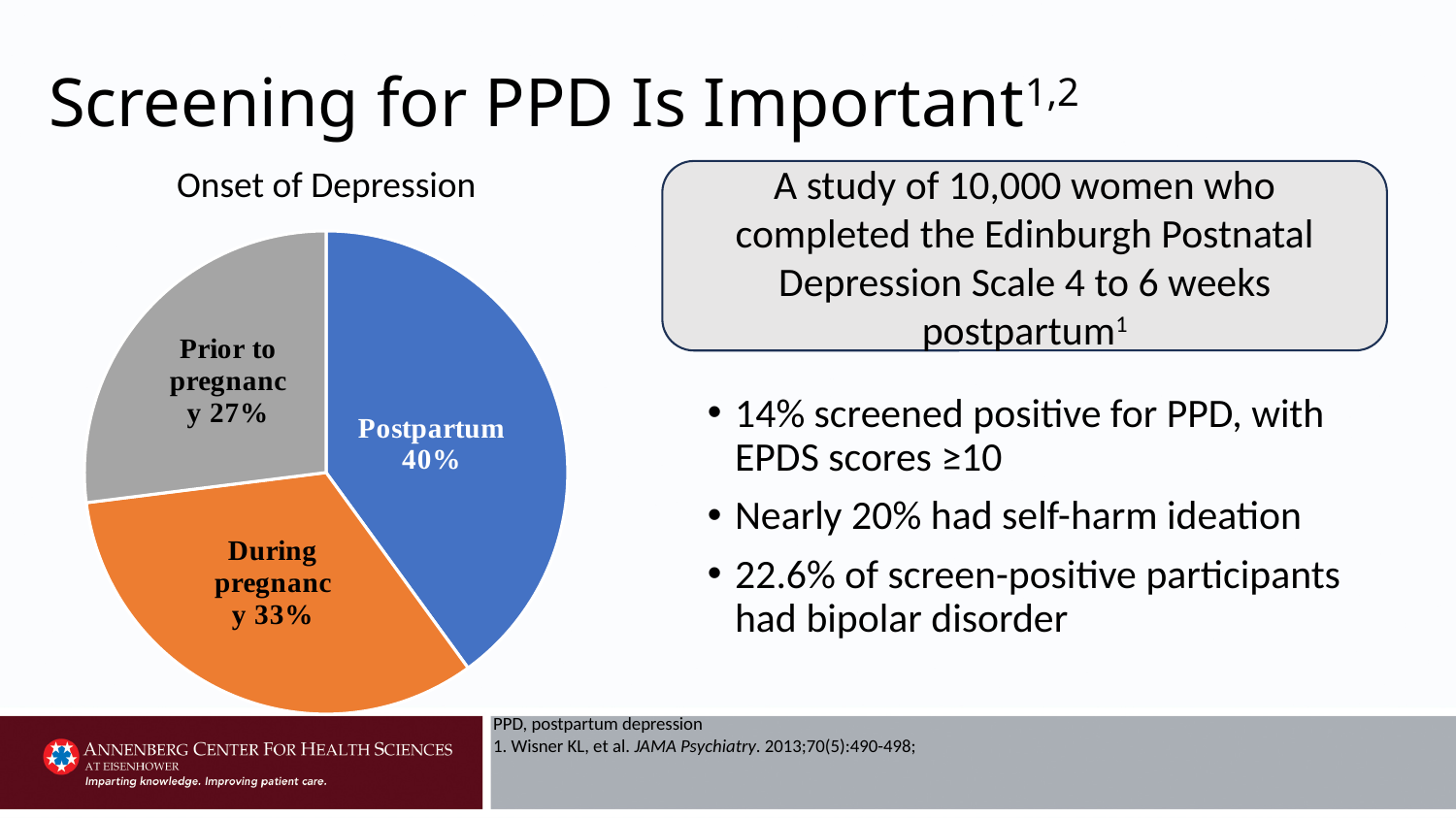
Which slice of the pie chart is the smallest? Prior to pregnancy What is the difference in percentage points between the Postpartum and During pregnancy slices? 7 What percentage of the pie chart is labelled Prior to pregnancy? 27% How many slices does the pie chart have? 3 What percentage of the pie chart is labelled Postpartum? 40% What percentage of the pie chart is labelled During pregnancy? 33% What is the difference in percentage points between the Postpartum and Prior to pregnancy slices? 13 Which slice of the pie chart is the largest? Postpartum What type of chart is shown on the slide? pie chart What colour is the Postpartum slice of the pie chart? blue What is the title of the pie chart? Onset of Depression Which is larger in the pie chart, During pregnancy or Prior to pregnancy? During pregnancy